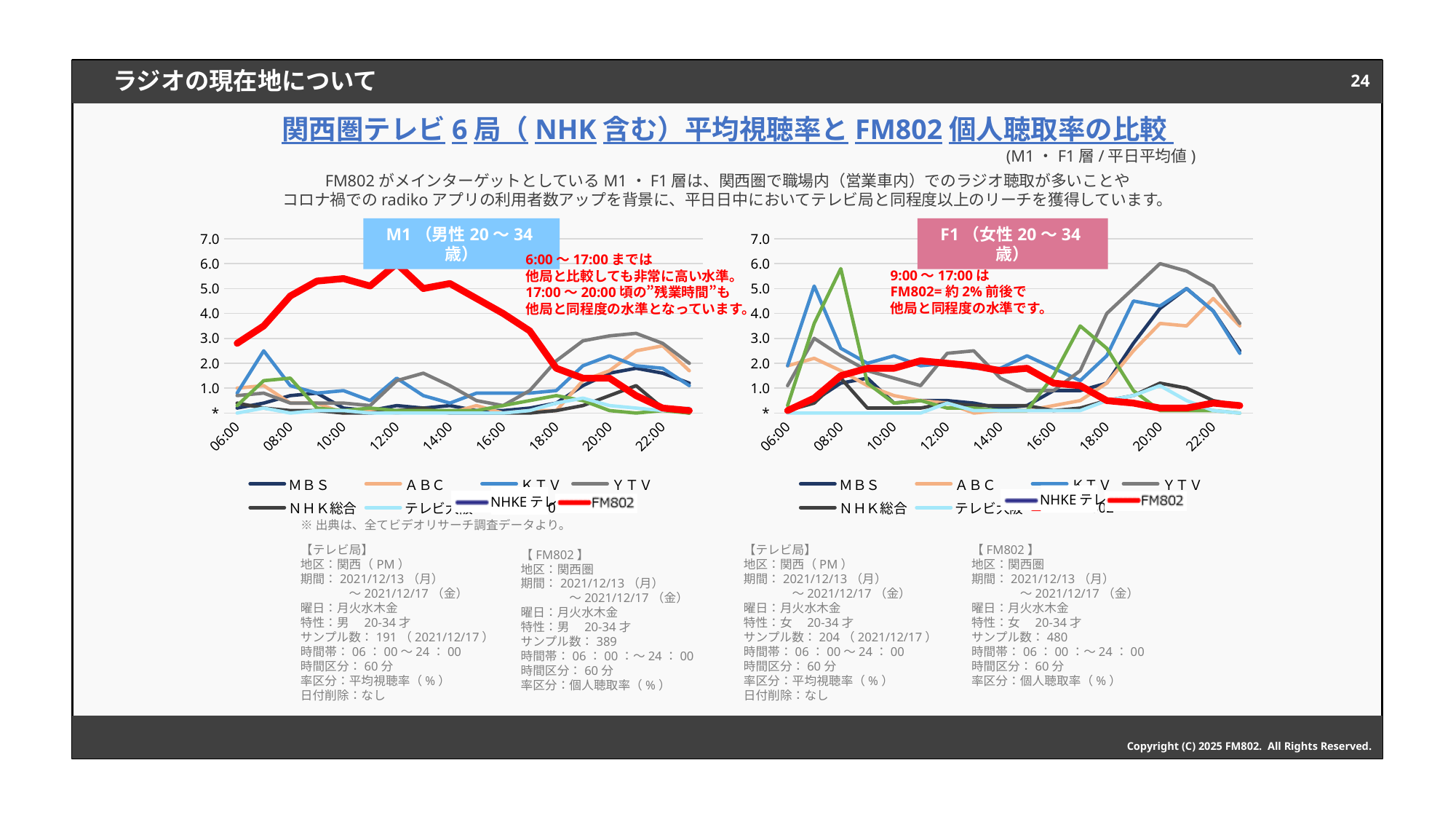
What kind of chart is the M1 chart on the left? line chart How many series does the legend of the F1 chart on the right list? 8 What colour is the FM802 line in both charts? red In the M1 chart on the left, is the value for FM802 at 10:00 greater or less than 4.0? greater In the F1 chart on the right, is the value for FM802 at 12:00 greater or less than 1.0? greater In the M1 chart on the left, which is larger at 10:00, FM802 or MBS? FM802 How many time labels are shown on the x axis of the M1 chart on the left? 9 In the M1 chart on the left, is the value for FM802 at 22:00 greater or less than 1.0? less In the M1 chart on the left, which series reaches the highest value on the chart? FM802 In the M1 chart on the left, does the FM802 line rise or fall from 12:00 to 22:00? fall What is the highest value shown on the y axis of the F1 chart on the right? 7.0